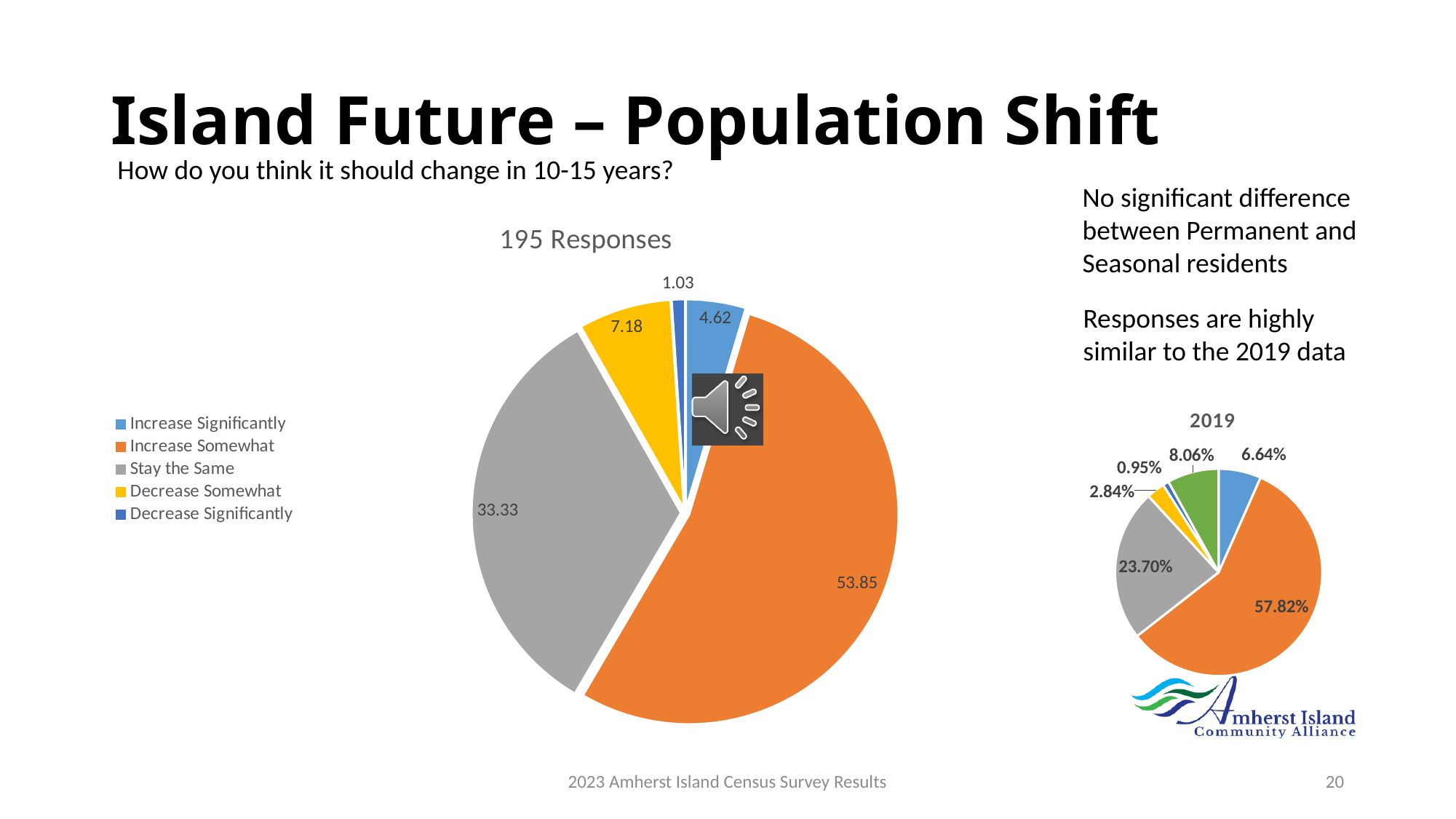
In the '2019' chart, what is the smallest slice's value? 0.95% In the '195 Responses' chart, which category has the largest slice? Increase Somewhat How many categories does the legend of the '195 Responses' chart list? 5 What kind of chart is the '195 Responses' chart? Pie chart In the '195 Responses' chart, what is the difference between the values for Increase Somewhat and Stay the Same? 20.52 In the '2019' chart, what is the largest slice's value? 57.82% In the '195 Responses' chart, which category has the smallest slice? Decrease Significantly In the '195 Responses' chart, what is the value for Stay the Same? 33.33 In the '195 Responses' chart, which is larger: Decrease Somewhat or Increase Significantly? Decrease Somewhat In the '195 Responses' chart, what is the value for Increase Significantly? 4.62 In the '195 Responses' chart, what is the value for Decrease Somewhat? 7.18 In the '195 Responses' chart, what is the value for Increase Somewhat? 53.85